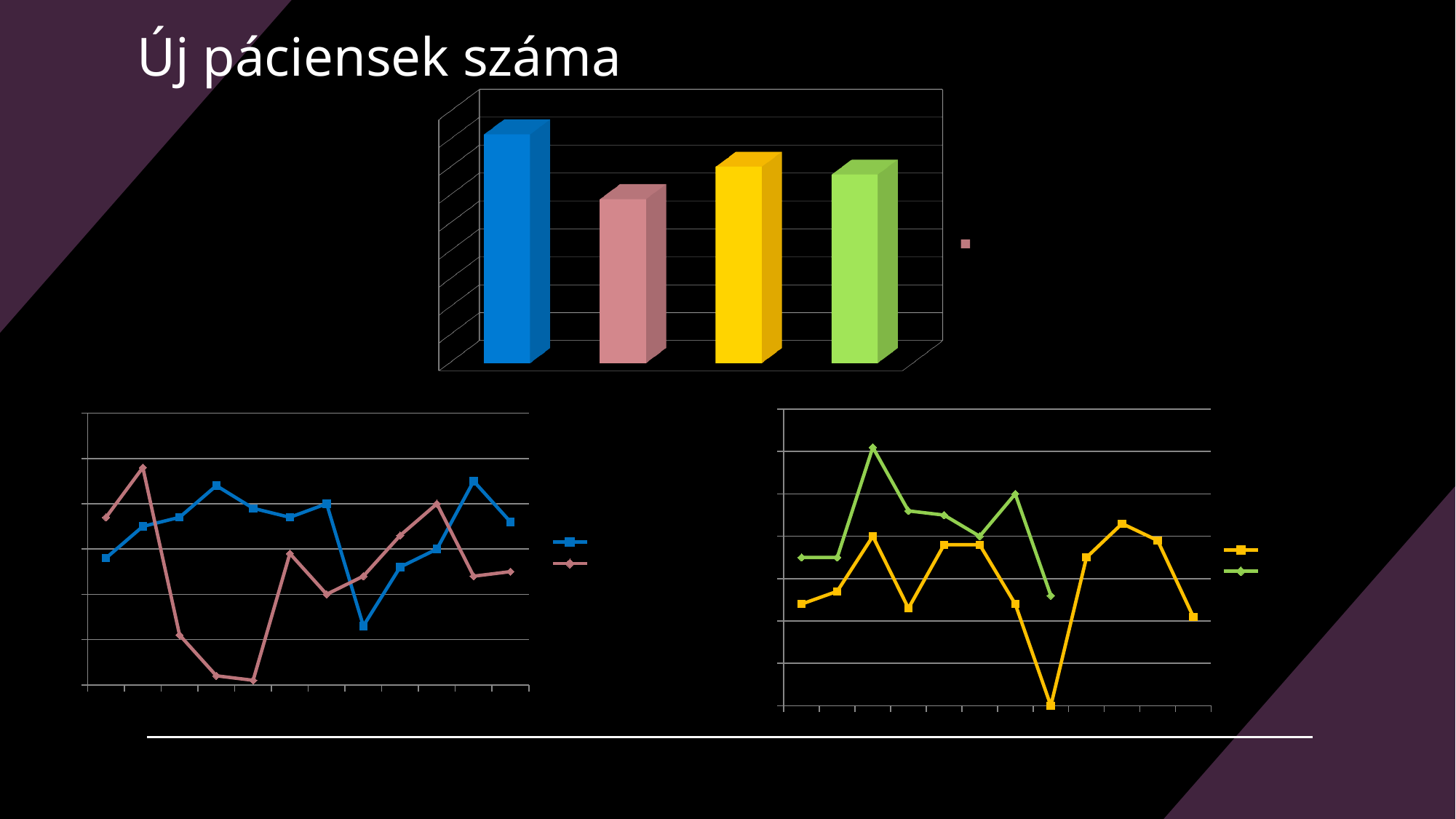
What kind of chart is the chart at the bottom right of the slide? line chart In the bar chart at the top of the slide, which bar is the shortest? the pink bar (second from the left) What is the title shown at the top of the slide? Új páciensek száma In the bar chart at the top of the slide, which bar is the tallest? the blue bar (first from the left) How many series does the legend of the bottom-left line chart list? 2 In the bottom-left line chart, how many data points does the blue series have? 12 In the bar chart at the top of the slide, is the blue bar taller or shorter than the green bar? taller How many series does the legend of the bottom-right line chart list? 2 What kind of chart is the chart at the bottom left of the slide? line chart What kind of chart is the chart at the top of the slide? bar chart How many bars does the bar chart at the top of the slide show? 4 In the bottom-right line chart, how many data points does the green series have? 8